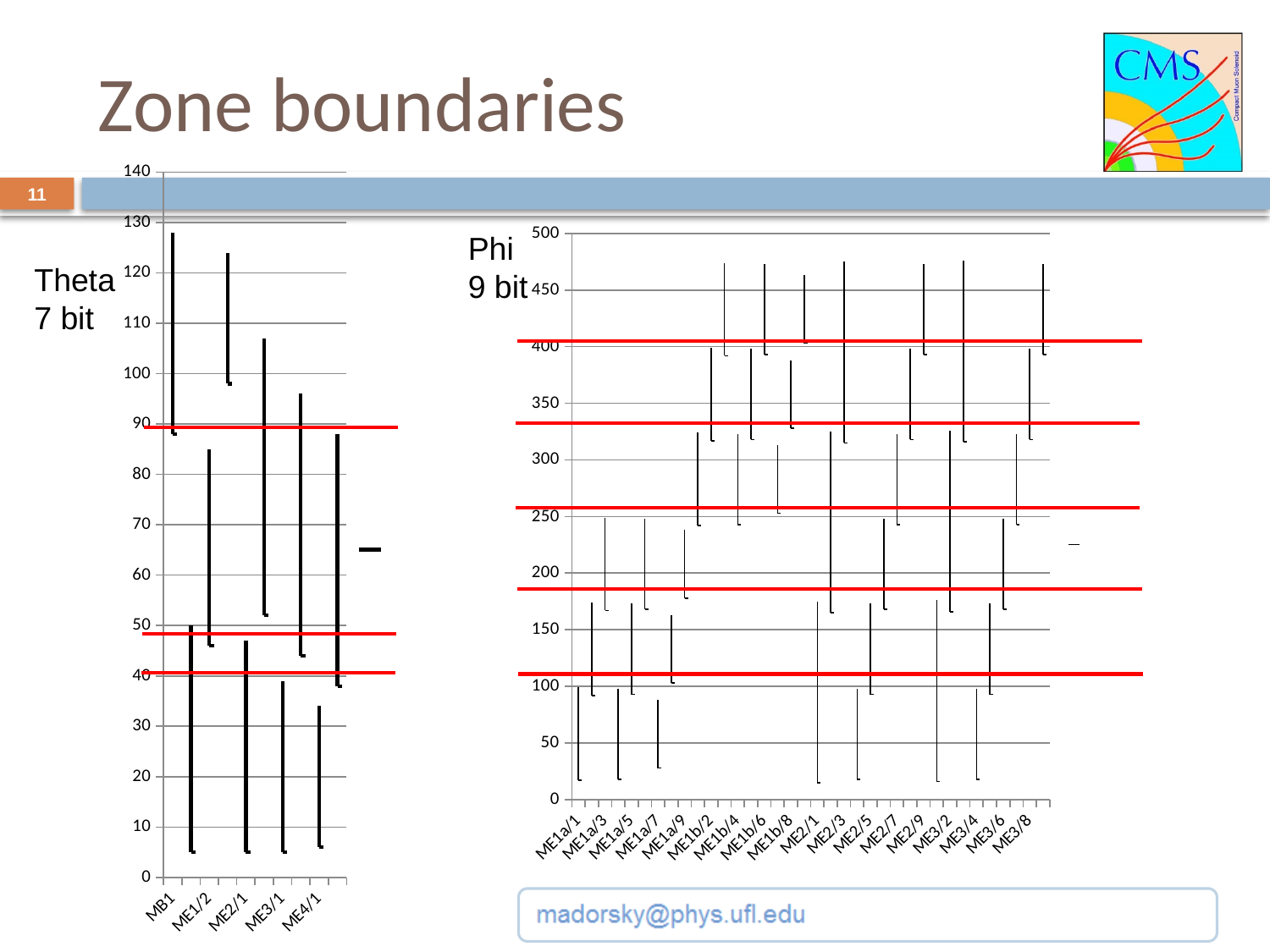
What is the last category label on the x axis of the right (Phi 9 bit) chart? ME3/8 What is the highest value shown on the y axis of the left (Theta 7 bit) chart? 140 In the left (Theta 7 bit) chart, is the top of the ME1/2 range greater or less than 120? less In the left (Theta 7 bit) chart, which category's range reaches the highest value? MB1 In the right (Phi 9 bit) chart, is the top of the ME1a/1 range greater or less than 200? less In the left (Theta 7 bit) chart, is the top of the MB1 range greater or less than 120? greater What is the highest value shown on the y axis of the right (Phi 9 bit) chart? 500 How many categories are labelled on the x axis of the right (Phi 9 bit) chart? 18 What is the first category label on the x axis of the left (Theta 7 bit) chart? MB1 How many categories are labelled on the x axis of the left (Theta 7 bit) chart? 5